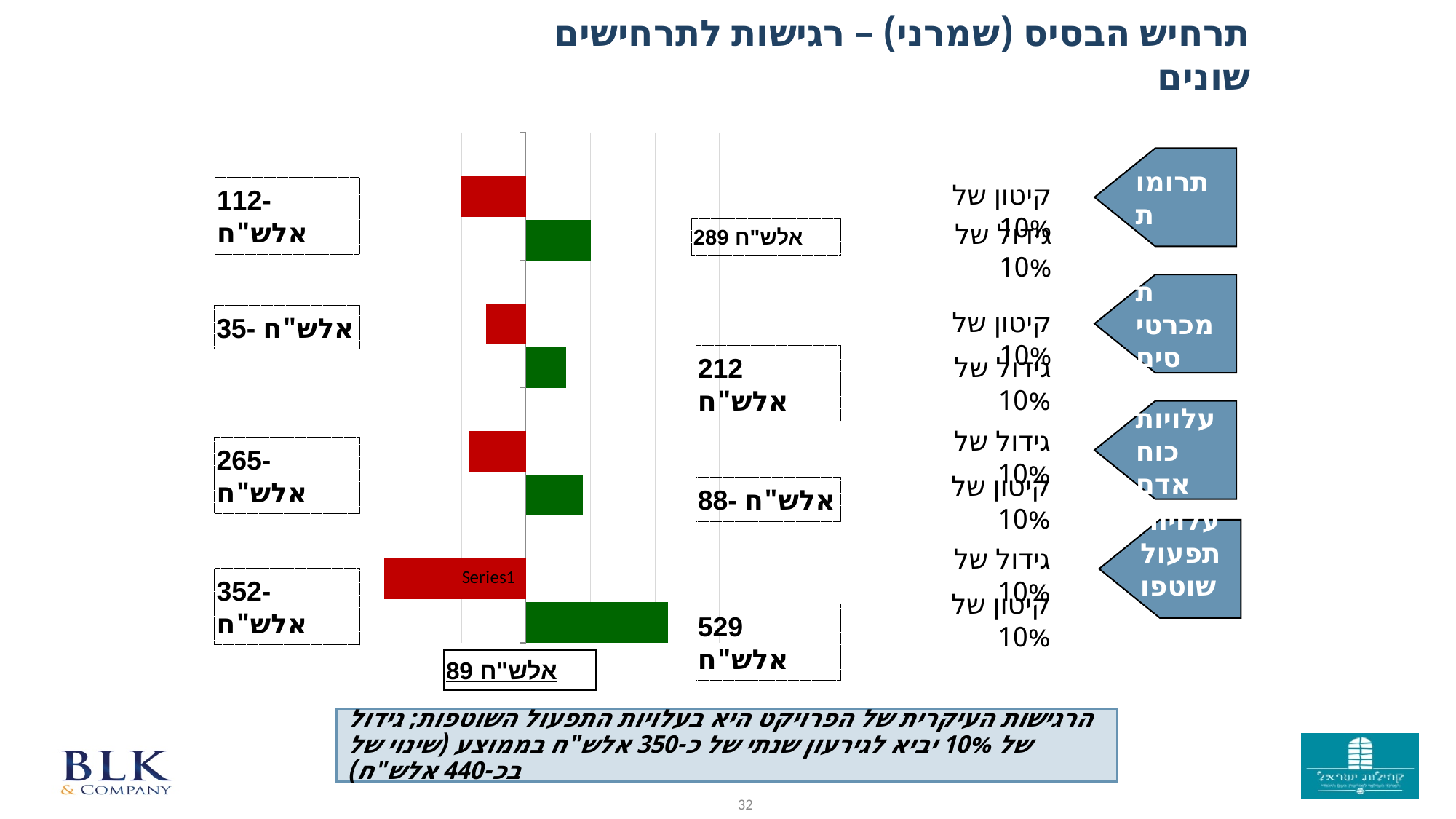
Which category has the longest red bar? עלויות תפעול שוטפות How many bars are plotted in the chart? 8 Which category has the longest green bar? עלויות תפעול שוטפות What value is labelled for the green bar of תרומות (growth of 10%)? 289 אלש"ח What kind of chart is shown on the slide? bar chart What value is labelled for the green bar of עלויות תפעול שוטפות? 529 אלש"ח What series name is printed on the chart? Series1 What value is labelled for the red bar of עלויות תפעול שוטפות? -352 אלש"ח Which category has the shortest red bar? מכרטיסים What value is labelled for the red bar of מכרטיסים? -35 אלש"ח Which green bar is longer, the one for תרומות or the one for מכרטיסים? תרומות What value is labelled for the red bar of תרומות (decrease of 10%)? -112 אלש"ח